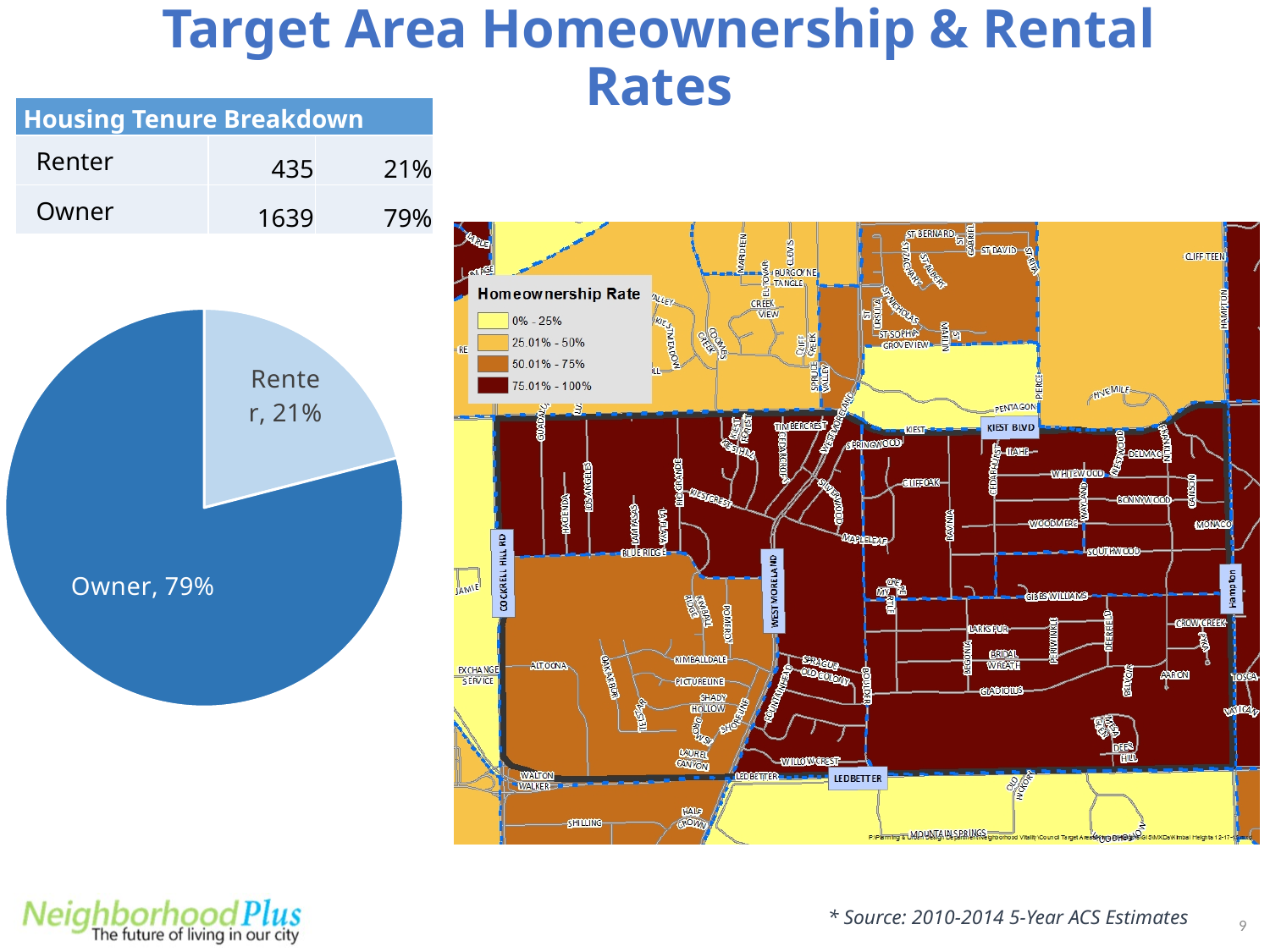
Which slice of the pie chart is the largest? Owner What colour is the Owner slice in the pie chart? dark blue Is the Renter share in the pie chart greater or less than 25%? less Is the Owner share in the pie chart greater or less than 75%? greater In the pie chart, what share does the Owner slice represent? 79% What is the difference in percentage points between the Owner and Renter slices of the pie chart? 58 In the pie chart, what share does the Renter slice represent? 21% What kind of chart is shown on the left of the slide? pie chart How many slices does the pie chart have? 2 In the pie chart, which is larger, the Owner slice or the Renter slice? Owner What is the title of the table above the pie chart? Housing Tenure Breakdown Which slice of the pie chart is the smallest? Renter